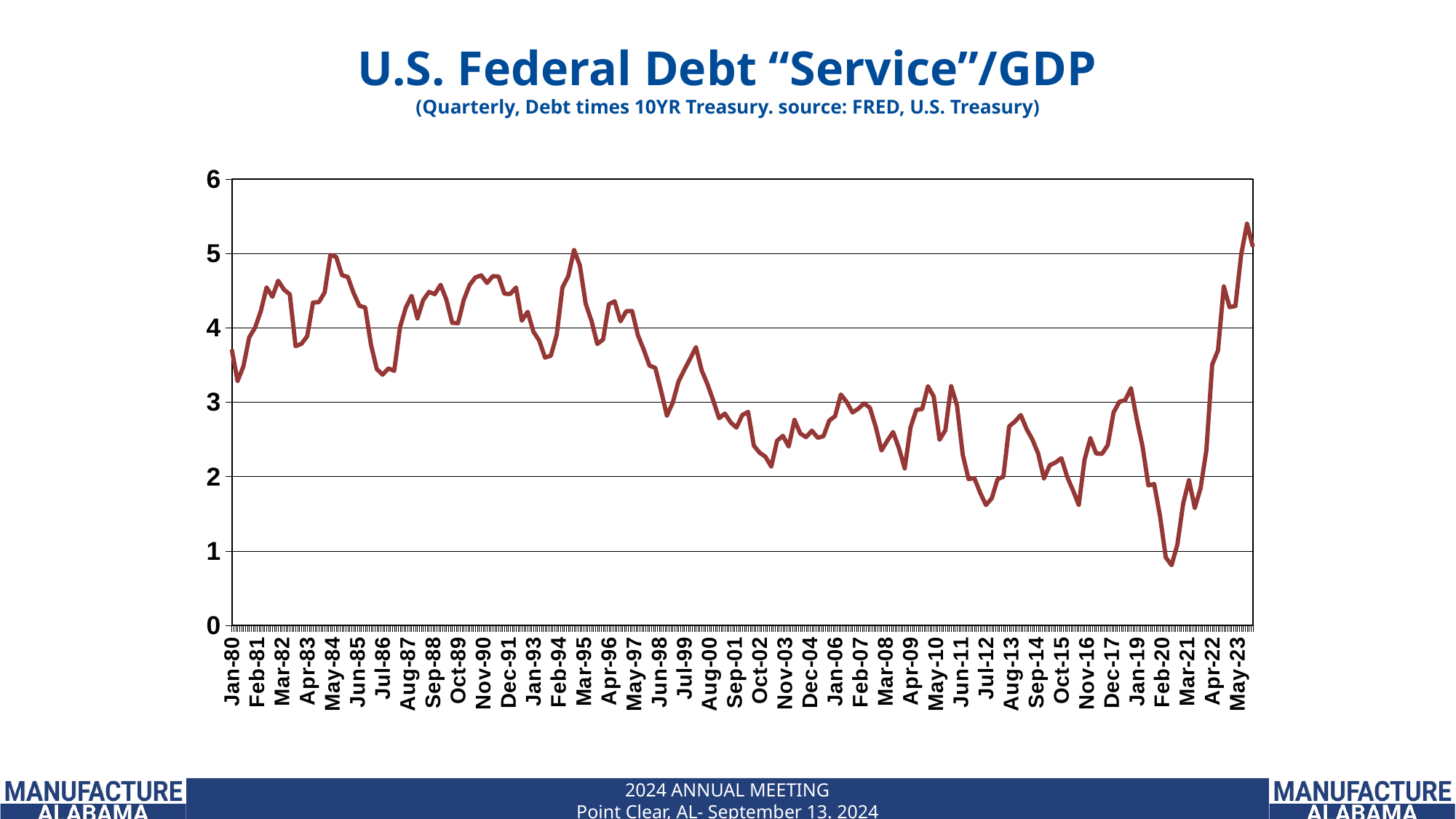
What is the title of the chart? U.S. Federal Debt "Service"/GDP Is the value at Jul-86 greater or less than 4? less Around which x-axis label does the line reach its lowest value? Feb-20 Is the value around May-84 higher or lower than the value around Jul-99? higher According to the subtitle, what are the data sources for the chart? FRED, U.S. Treasury Is the value at Oct-02 greater or less than 3? less Is the lowest point of the line, around Feb-20, greater or less than 1? less Does the line overall rise or fall between Feb-20 and May-23? rise Does the line overall rise or fall between Mar-95 and Oct-02? fall What kind of chart is shown on the slide? line chart